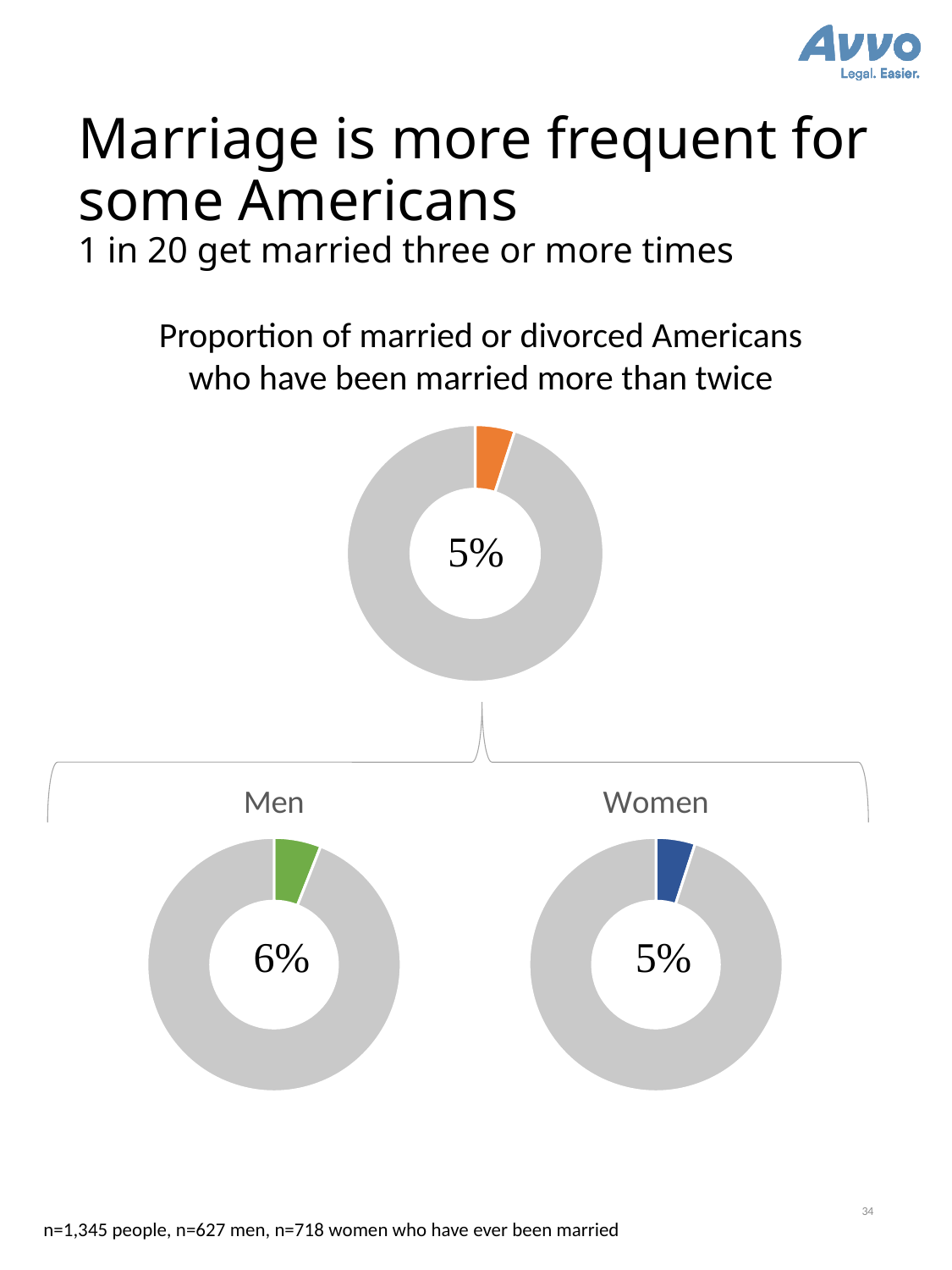
Is the value in the top chart the same as the value in the Women chart? Yes In the Men chart, what colour is the highlighted slice? Green What kind of chart is the top chart showing the overall proportion? Doughnut chart Comparing the Men and Women charts, which group has the higher proportion married more than twice? Men What is the title of the top chart? Proportion of married or divorced Americans who have been married more than twice In the top chart, what proportion of married or divorced Americans have been married more than twice? 5% What is the difference between the Men chart value and the Women chart value? 1% In the Men chart, what proportion have been married more than twice? 6% In the Women chart, what proportion have been married more than twice? 5% Is the value in the Women chart greater or less than 10%? less How many doughnut charts are shown on the slide? 3